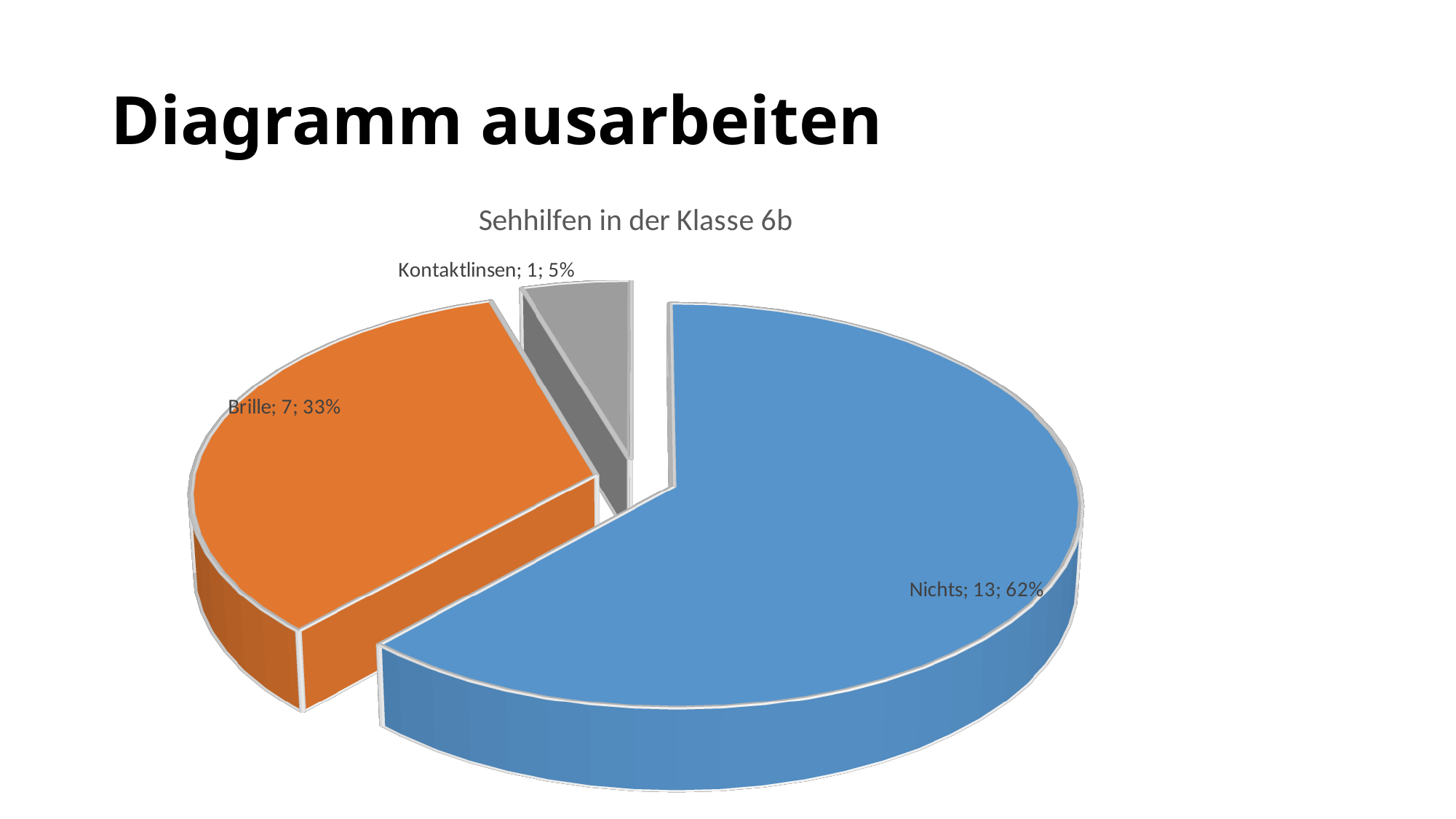
What is the title of the chart? Sehhilfen in der Klasse 6b How many slices does the pie chart have? 3 Which is larger, the value for Brille or the value for Kontaktlinsen? Brille Which category has the largest slice? Nichts What is the value for Nichts? 13 What kind of chart is shown on the slide? pie chart What share of the pie does Nichts represent? 62% What is the value for Kontaktlinsen? 1 What is the difference between the values for Nichts and Brille? 6 Which category has the smallest slice? Kontaktlinsen What share of the pie does Brille represent? 33% What is the value for Brille? 7